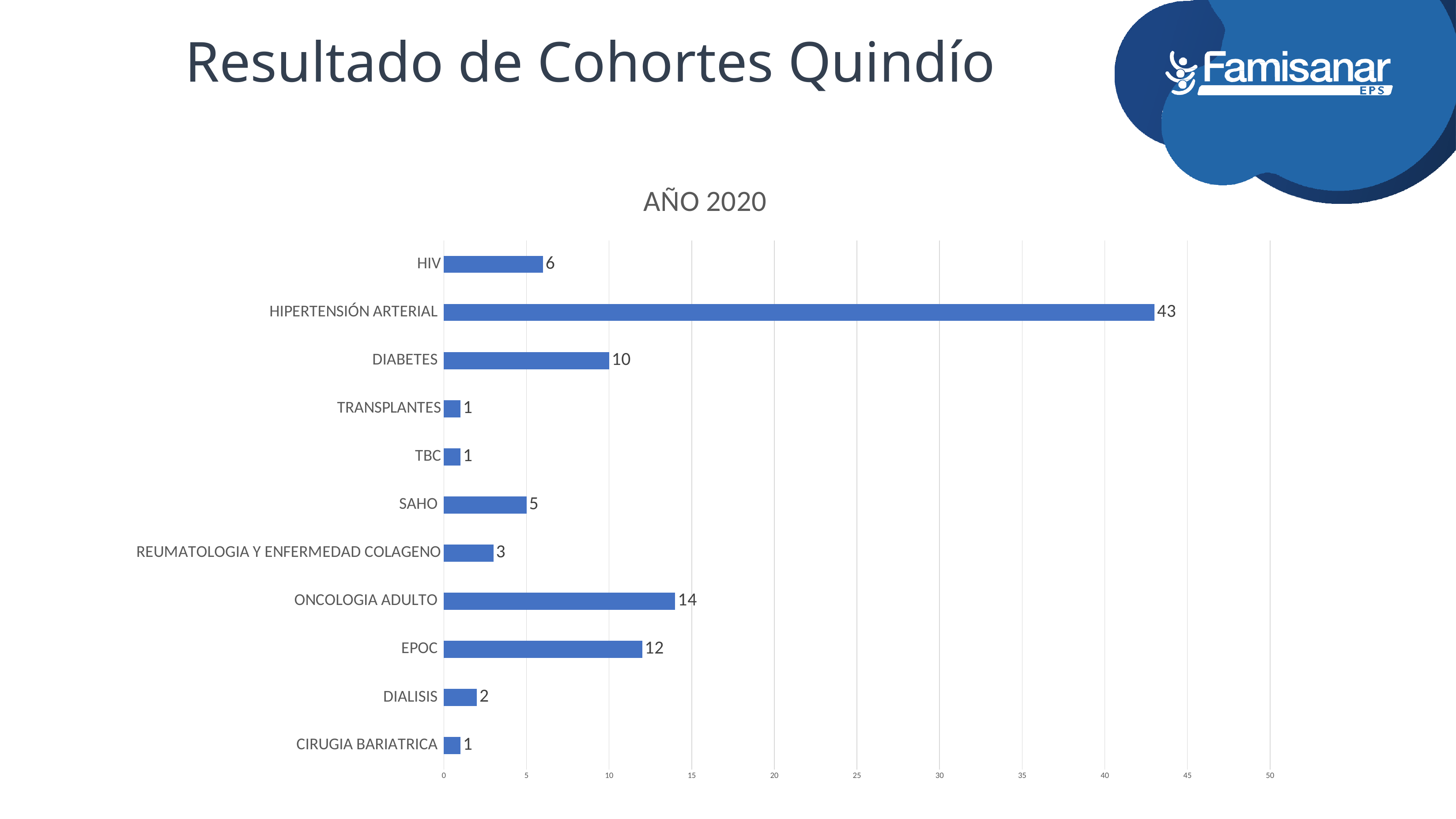
How many categories are shown in the chart? 11 Is the value for HIPERTENSIÓN ARTERIAL greater or less than 40? greater What kind of chart is shown on the slide? bar chart What is the value for REUMATOLOGIA Y ENFERMEDAD COLAGENO? 3 What is the value for SAHO? 5 What is the difference between the values for ONCOLOGIA ADULTO and EPOC? 2 What is the difference between the values for HIPERTENSIÓN ARTERIAL and DIABETES? 33 Which is larger, the value for HIV or the value for DIALISIS? HIV What is the value for HIPERTENSIÓN ARTERIAL? 43 What is the value for ONCOLOGIA ADULTO? 14 Which category has the highest value? HIPERTENSIÓN ARTERIAL What is the title of the chart? AÑO 2020